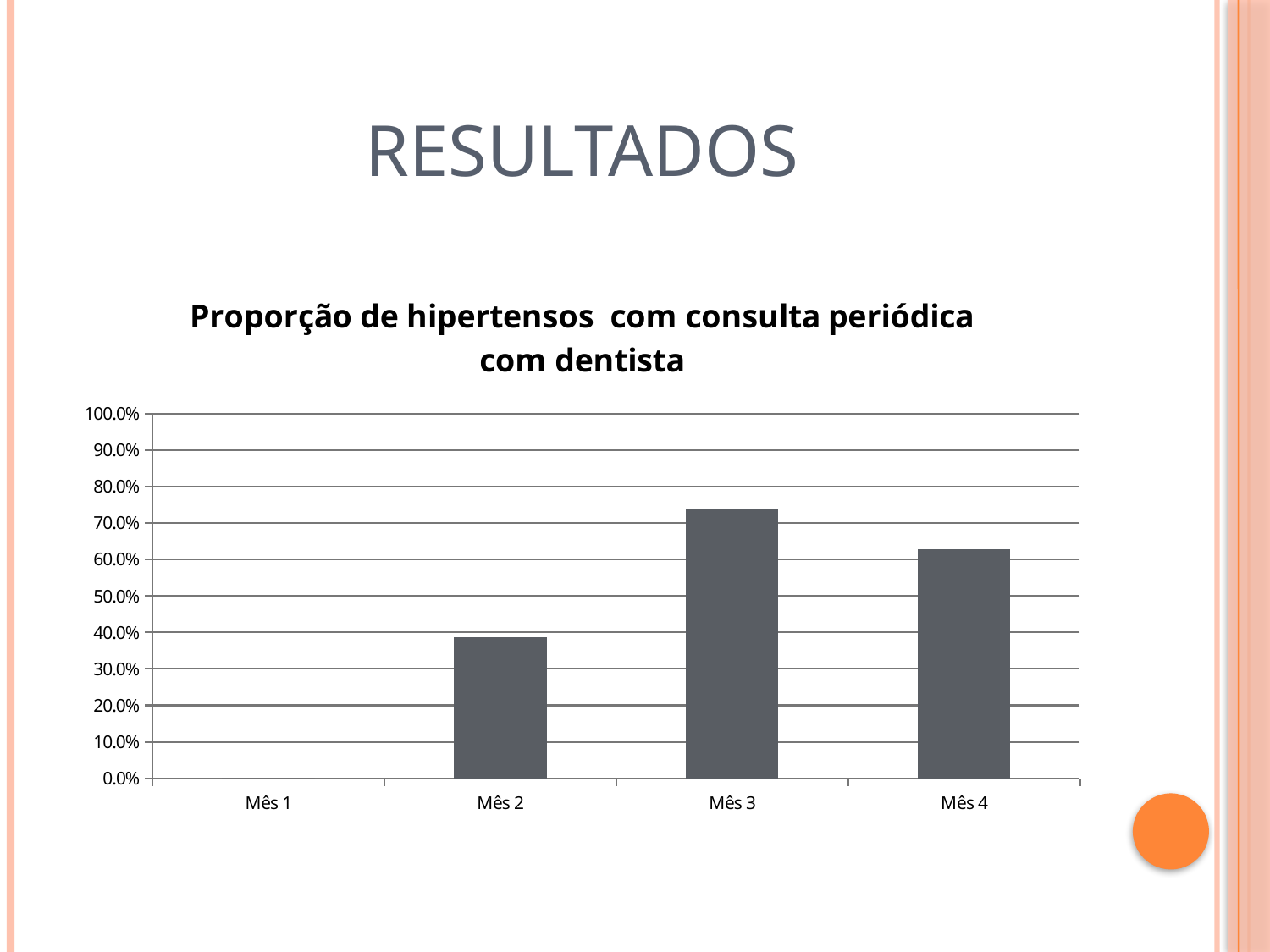
Which is larger, the value for Mês 2 or the value for Mês 4? Mês 4 What kind of chart is shown on the slide? bar chart Which month has the lowest proportion of hypertensive patients with periodic dental consultation? Mês 1 How many months (categories) are shown on the x axis of the chart? 4 What is the title of the chart? Proporção de hipertensos com consulta periódica com dentista Is the value for Mês 3 greater or less than 70.0%? greater Is the value for Mês 4 greater or less than 60.0%? greater Is the value for Mês 2 greater or less than 50.0%? less Which is larger, the value for Mês 3 or the value for Mês 4? Mês 3 Which month has the highest proportion of hypertensive patients with periodic dental consultation? Mês 3 Do the values rise or fall from Mês 1 to Mês 3? rise